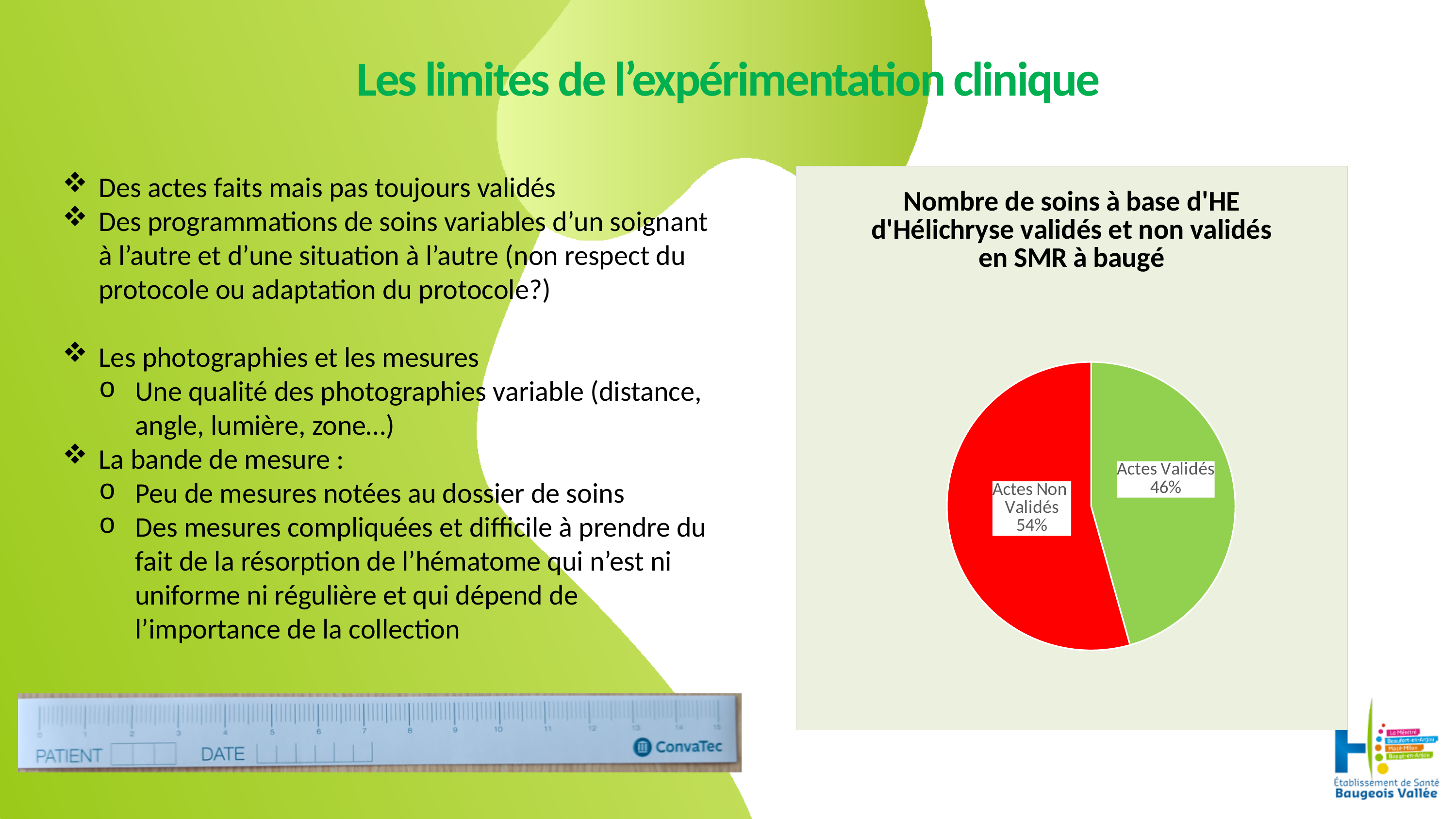
What share of the pie does Actes Non Validés represent? 54% What is the title of the chart? Nombre de soins à base d'HE d'Hélichryse validés et non validés en SMR à baugé What is the difference in percentage points between Actes Non Validés and Actes Validés? 8% Which slice of the pie is the largest? Actes Non Validés Which slice of the pie is the smallest? Actes Validés What share of the pie does Actes Validés represent? 46% How many slices does the pie chart have? 2 Is the share for Actes Validés greater or less than 50%? less What colour is the Actes Non Validés slice? Red What kind of chart is shown on the slide? Pie chart Which is larger, Actes Validés or Actes Non Validés? Actes Non Validés